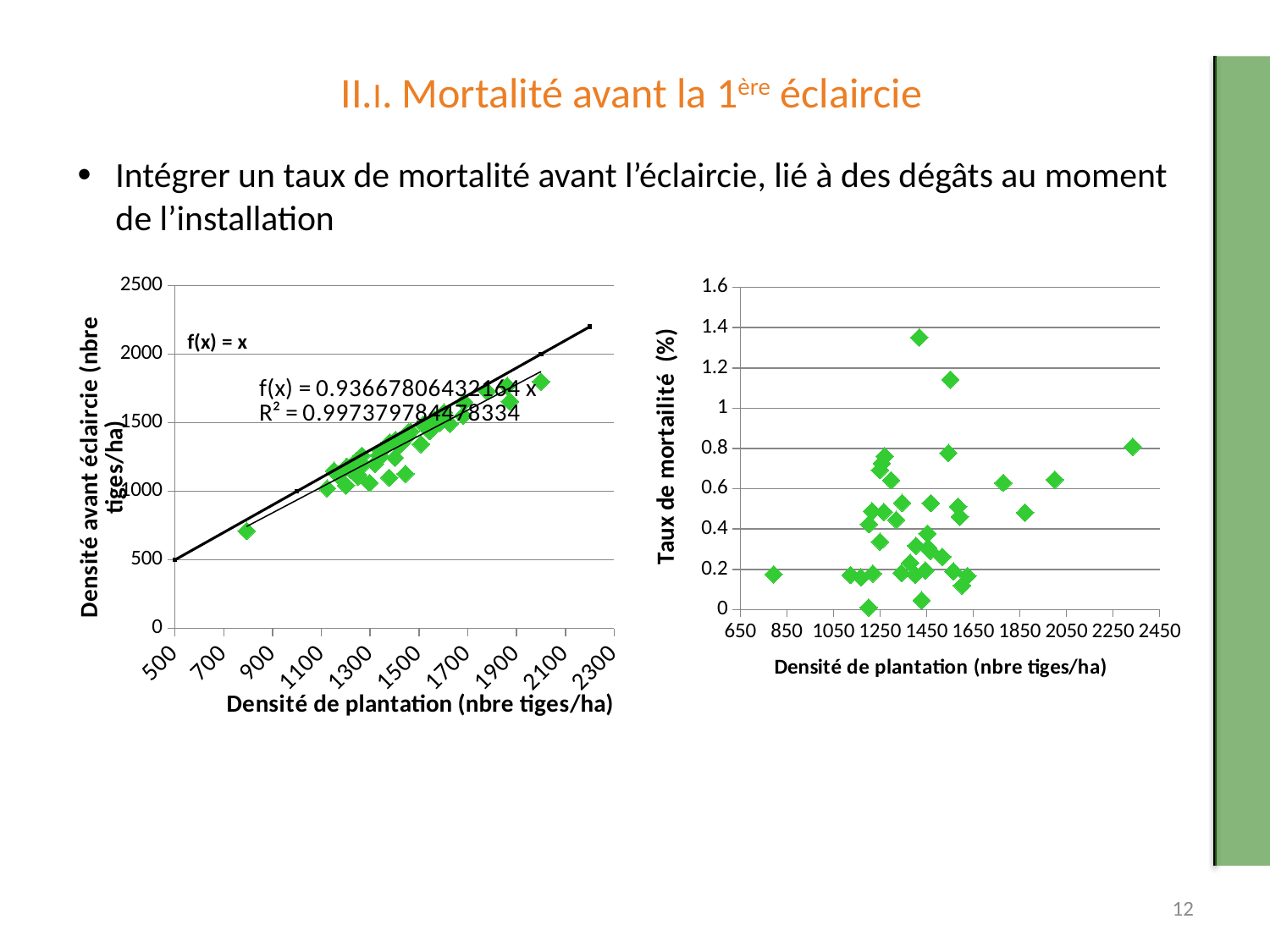
In the left chart, what is the equation of the fitted trendline shown on the chart? f(x) = 0.936678064321644 x In the left chart, what is the maximum value shown on the y axis? 2500 What is the y-axis title of the right chart? Taux de mortailité (%) In the left chart, is the density before thinning for the point at a planting density of about 850 greater or less than 1000? less In the right chart, is the mortality rate for the point at a planting density of about 800 greater or less than 0.4? less What kind of chart is the right chart on the slide? scatter chart In the left chart, do the plotted values rise or fall as the planting density increases along the x axis? rise What kind of chart is the left chart on the slide? scatter chart In the right chart, what is the maximum value shown on the y axis? 1.6 In the left chart, what R² value is printed on the chart? R² = 0.997379784478334 In the right chart, is the highest plotted mortality rate greater or less than 1.2? greater